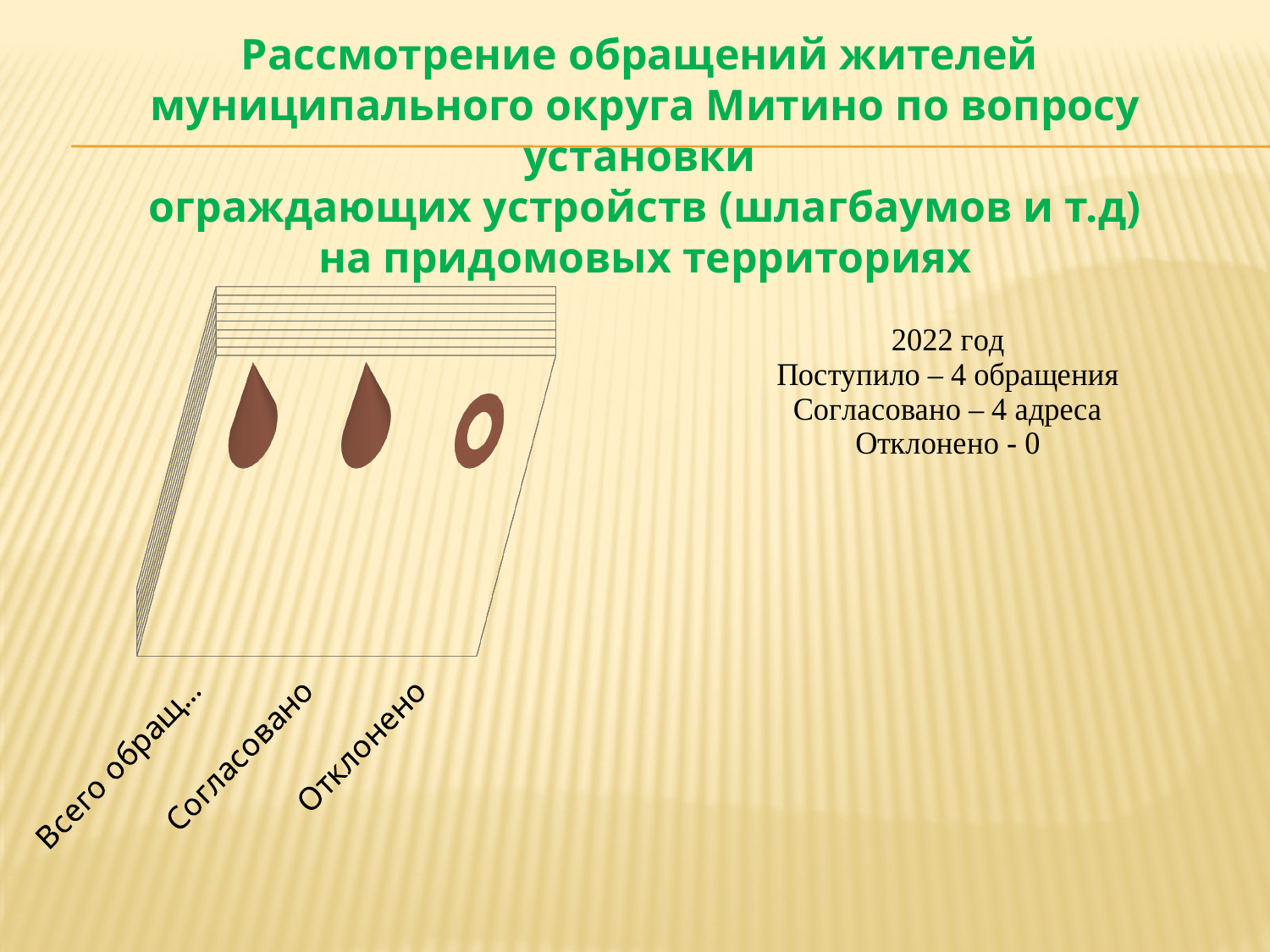
What is the label of the last category on the chart's horizontal axis? Отклонено Which is larger on the chart, the value for the first category (Всего обращ...) or the value for Отклонено? Всего обращ... What is the label of the second category on the chart's horizontal axis? Согласовано Which category on the chart has the lowest value? Отклонено How many categories are shown on the chart's horizontal axis? 3 What kind of chart is shown on the slide? bar chart Which is larger on the chart, the value for Согласовано or the value for Отклонено? Согласовано